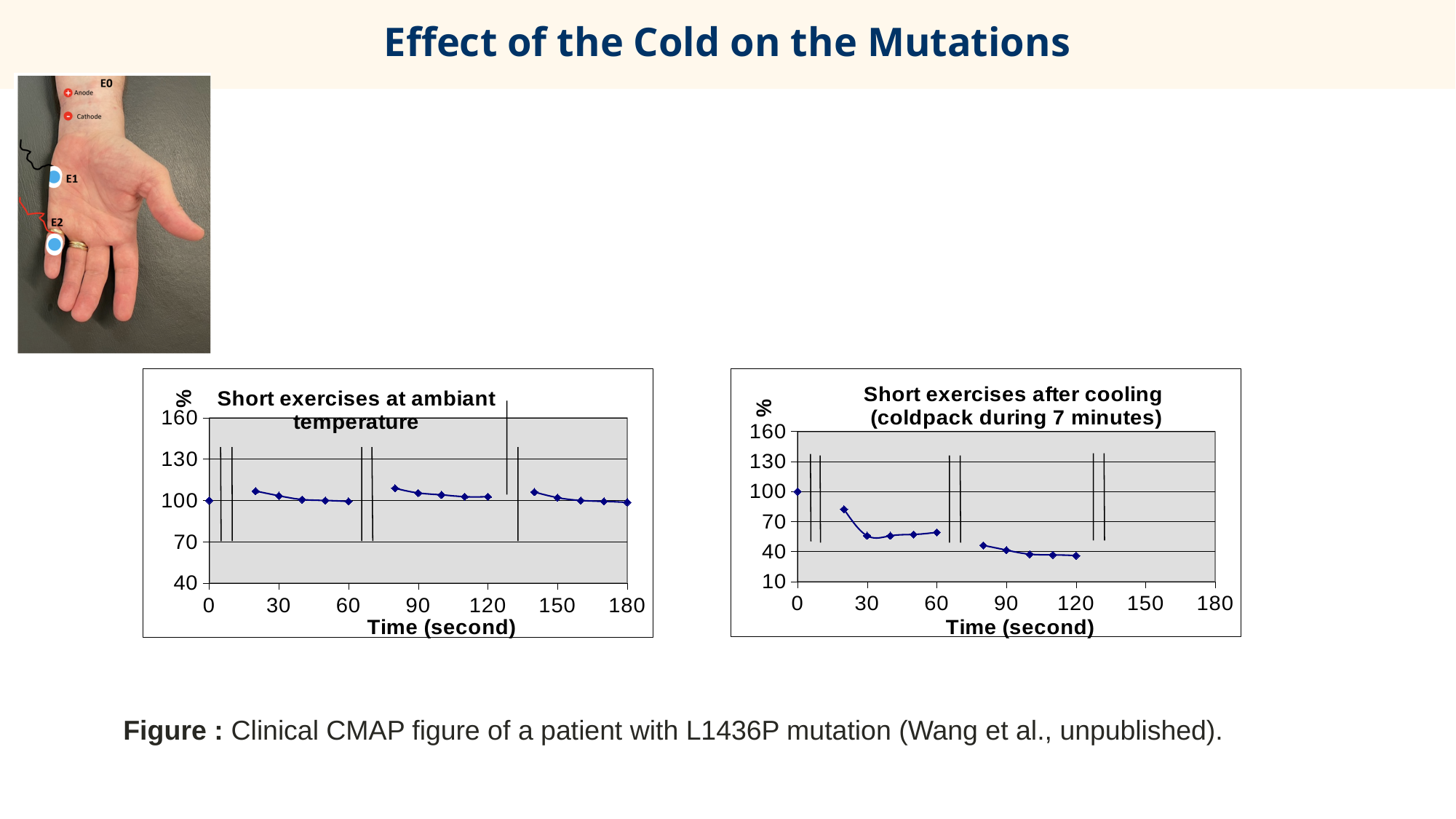
What is the label of the x axis on the 'Short exercises after cooling' chart? Time (second) What kind of chart is the 'Short exercises after cooling' chart? line chart In the 'Short exercises at ambiant temperature' chart, what is the value (%) at time 0 seconds? 100 In the 'Short exercises after cooling' chart, is the value at 120 seconds greater or less than 40? less In the 'Short exercises after cooling' chart, do the values overall rise or fall as time increases? fall What is the title of the chart on the right side of the slide? Short exercises after cooling (coldpack during 7 minutes) In the 'Short exercises at ambiant temperature' chart, is the value at 80 seconds greater or less than 100? greater What kind of chart is the 'Short exercises at ambiant temperature' chart? line chart In the 'Short exercises after cooling' chart, is the value at 30 seconds greater or less than 70? less In the 'Short exercises after cooling' chart, what is the value (%) at time 0 seconds? 100 In the 'Short exercises after cooling' chart, which is larger: the value at 0 seconds or the value at 120 seconds? 0 seconds